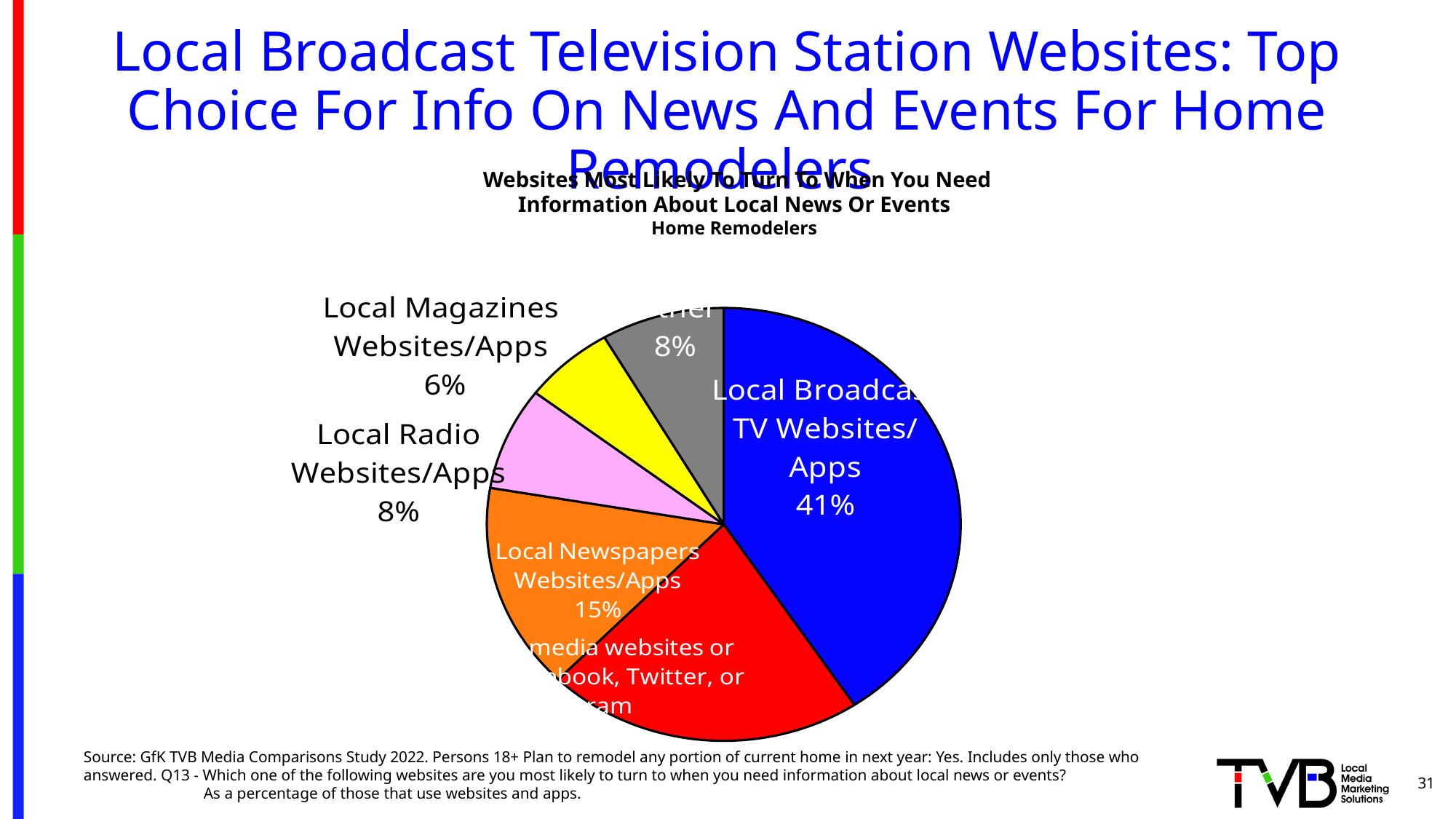
What colour is the Local Broadcast TV Websites/Apps slice? blue Which website category has the smallest slice of the pie? Local Magazines Websites/Apps Which slice is larger: Local Newspapers Websites/Apps or Local Magazines Websites/Apps? Local Newspapers Websites/Apps How many slices does the pie chart have? 6 How many percentage points higher is Local Broadcast TV Websites/Apps than Local Newspapers Websites/Apps? 26 What percentage is shown for Local Radio Websites/Apps? 8% What is the difference in percentage points between Local Radio Websites/Apps and Local Magazines Websites/Apps? 2 What percentage is shown for Local Magazines Websites/Apps? 6% What percentage of home remodelers are most likely to turn to Local Broadcast TV Websites/Apps for local news or events? 41% What share of the pie is Local Newspapers Websites/Apps? 15% Which website category has the largest slice of the pie? Local Broadcast TV Websites/Apps What kind of chart is shown on the slide? pie chart